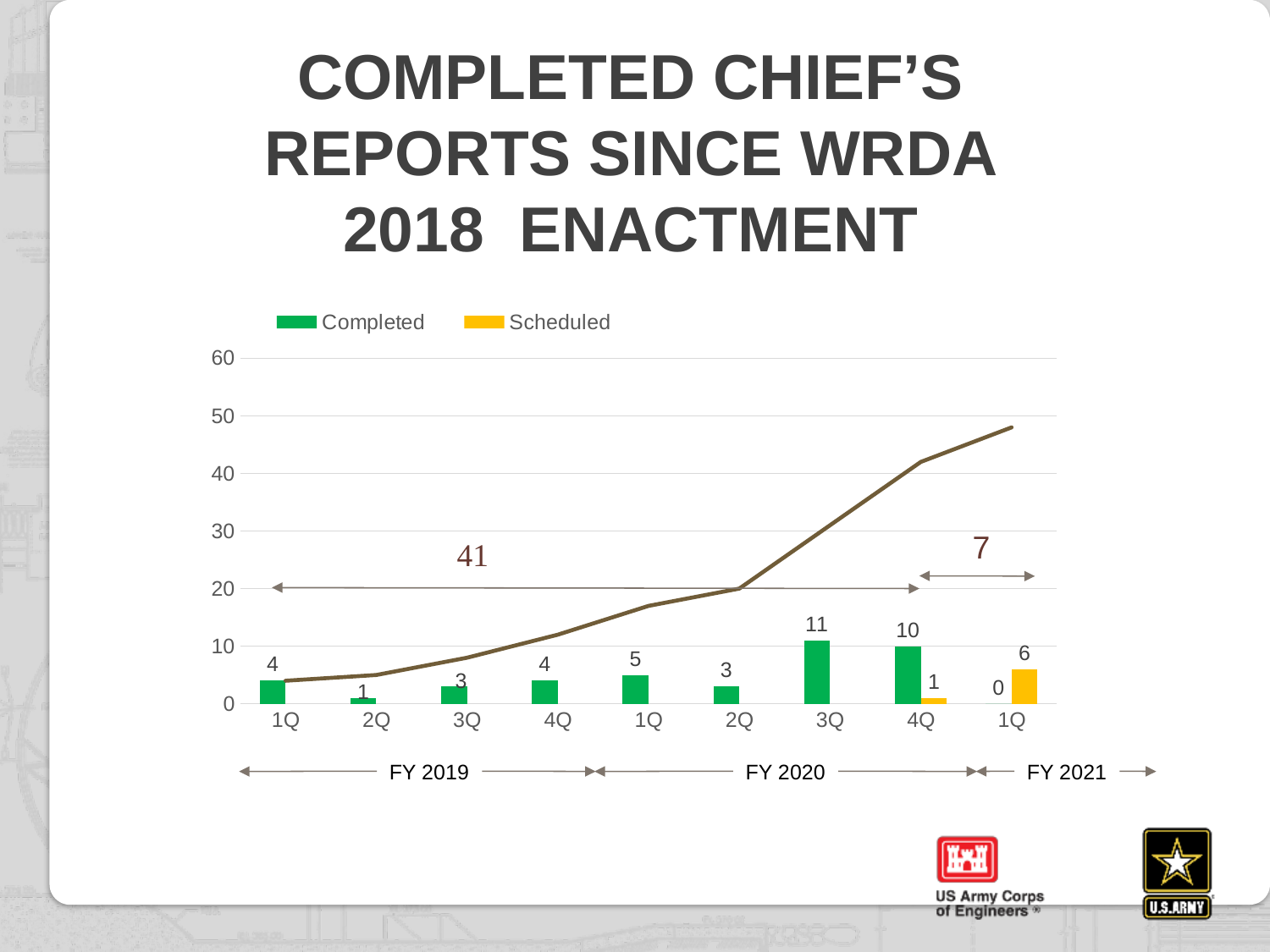
Is the cumulative line value at 1Q FY 2021 greater or less than 40? greater What number is annotated above the long arrow spanning FY 2019 through 4Q FY 2020? 41 What is the Completed value for 1Q of FY 2021? 0 How many quarters are shown on the x axis? 9 What is the Scheduled value for 1Q of FY 2021? 6 Which quarter has the highest Completed value? 3Q FY 2020 What is the Completed value for 2Q of FY 2019? 1 Which is larger, the Completed value for 1Q FY 2020 or the Completed value for 2Q FY 2020? 1Q FY 2020 How many series does the legend list? 2 What colour are the Scheduled bars? Yellow How many Chief's Reports were completed in 3Q of FY 2020? 11 What is the difference between the Completed values for 3Q FY 2020 and 4Q FY 2020? 1